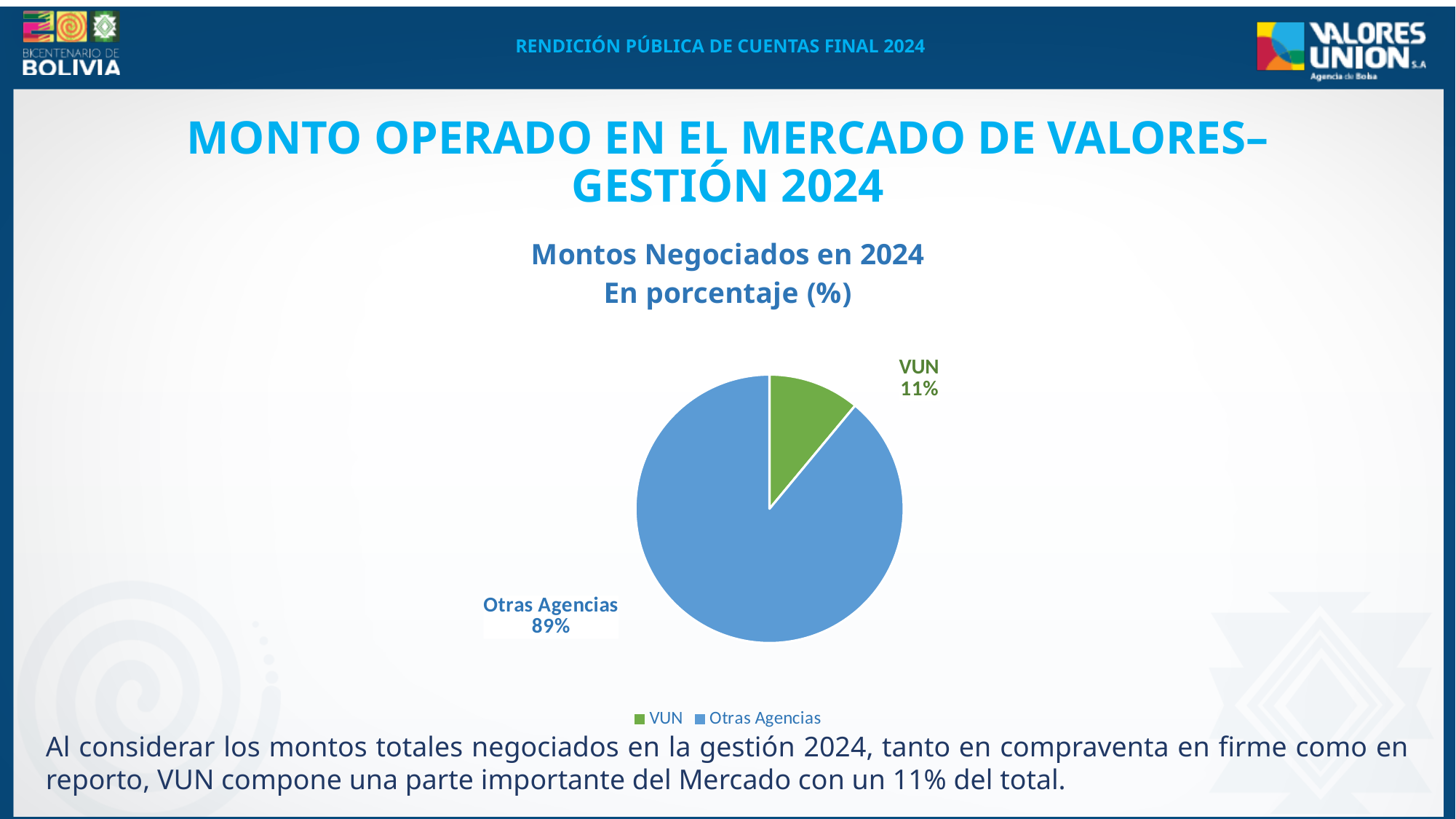
What type of chart is shown on the slide? pie chart How many slices does the pie chart have? 2 What is the value for VUN? 11% Which category has the smallest share of the pie? VUN Which category has the largest share of the pie? Otras Agencias What colour is the VUN slice? green What is the difference between the shares of Otras Agencias and VUN? 78% What is the value for Otras Agencias? 89% What is the title of the chart? Montos Negociados en 2024 En porcentaje (%) Which is larger, the share for VUN or the share for Otras Agencias? Otras Agencias How many entries does the legend list? 2 What share of the pie does VUN represent? 11%